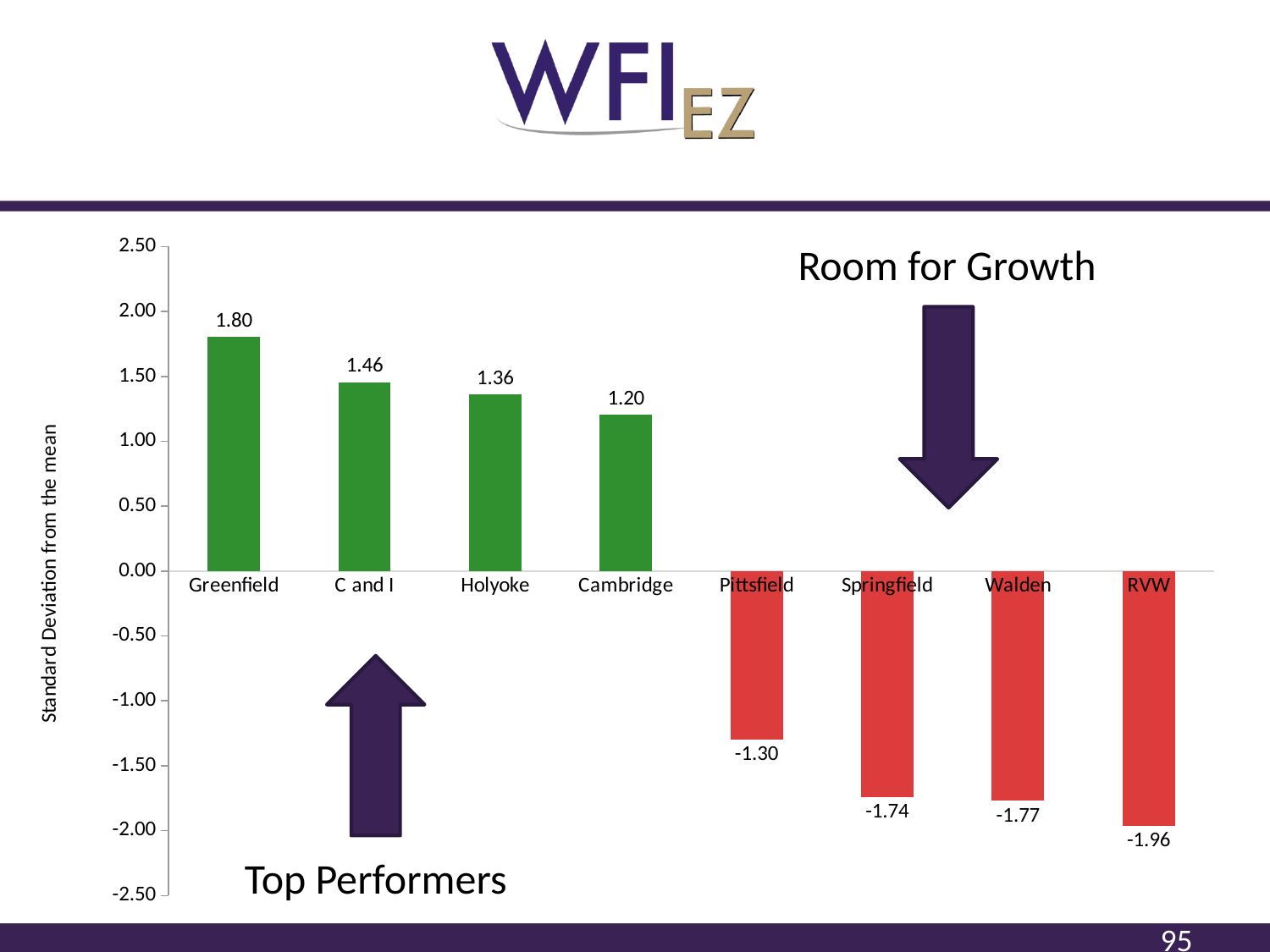
What is the value for Cambridge? 1.20 Which category has the highest value? Greenfield Do the values rise or fall from left to right along the x axis? fall Which is larger, the value for Holyoke or the value for Cambridge? Holyoke What is the value for Greenfield? 1.80 What is the value for Springfield? -1.74 How many categories are shown on the x axis? 8 What is the label on the vertical axis? Standard Deviation from the mean Which category has the lowest value? RVW What is the difference between the values for Pittsfield and RVW? 0.66 What is the difference between the values for Greenfield and C and I? 0.34 What kind of chart is this? bar chart